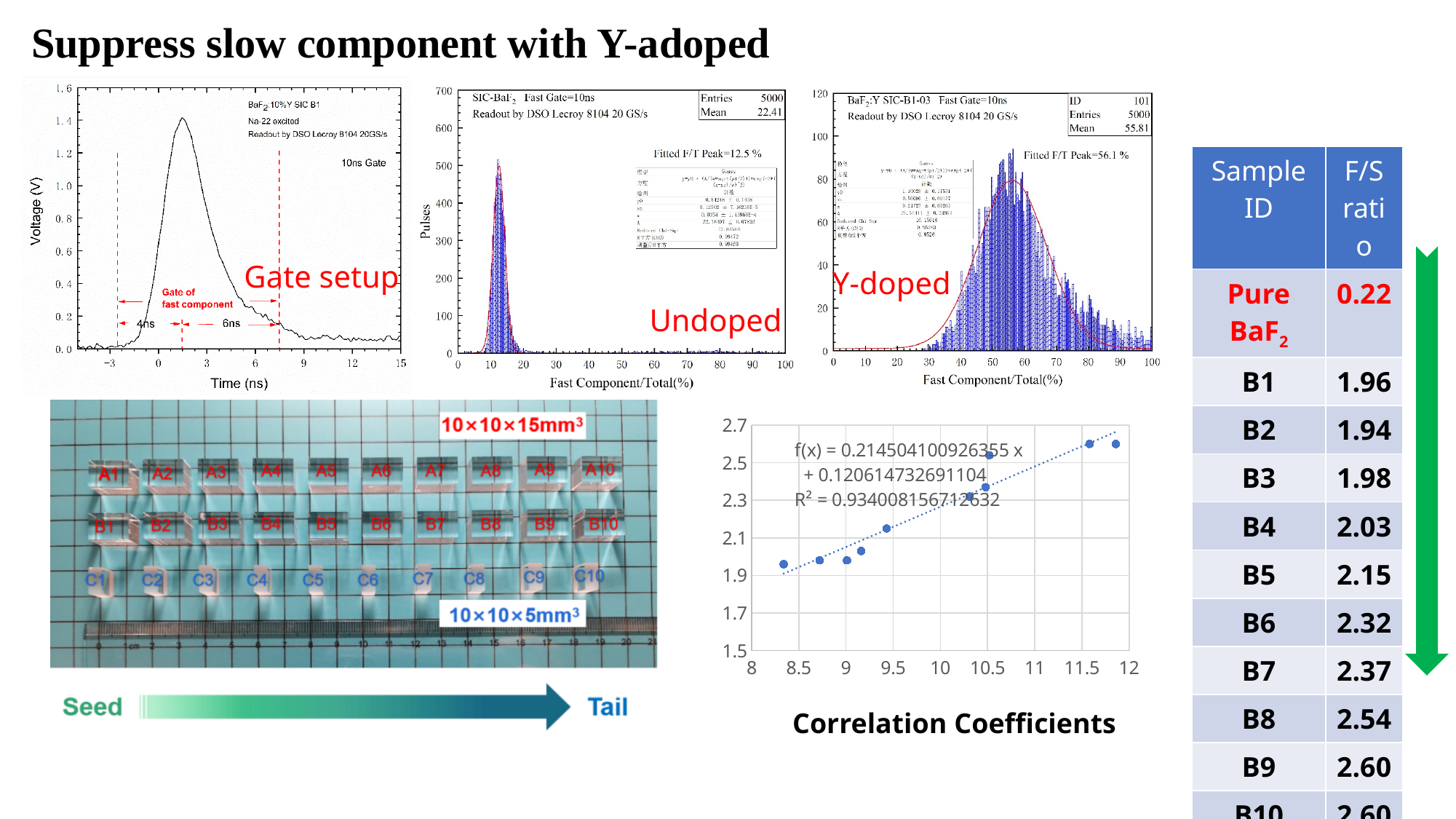
In the 'Correlation Coefficients' chart, is the y value of the leftmost point (near x = 8.5) greater or less than 2.1? less In the 'Undoped' histogram (middle top chart), what is the fitted F/T peak value? 12.5 % In the 'Y-doped' histogram (top right chart), what is the Mean value shown in the statistics box? 55.81 In the 'Y-doped' histogram (top right chart), what is the fitted F/T peak value? 56.1 % In the 'Correlation Coefficients' chart, what is the slope of the fitted trendline equation f(x)? 0.214504100926355 In the 'Correlation Coefficients' chart, do the plotted values rise or fall as the x value increases? rise In the 'Correlation Coefficients' chart, what is the highest value shown on the y axis? 2.7 In the 'Correlation Coefficients' chart, what R² value is printed for the trendline? R² = 0.934008156712632 In the 'Correlation Coefficients' chart, is the y value of the rightmost point (near x = 12) greater or less than 2.5? greater Which has the larger fitted F/T peak, the 'Undoped' histogram or the 'Y-doped' histogram? Y-doped What kind of chart is the 'Correlation Coefficients' chart? scatter chart In the 'Undoped' histogram (middle top chart), how many entries are listed in the statistics box? 5000